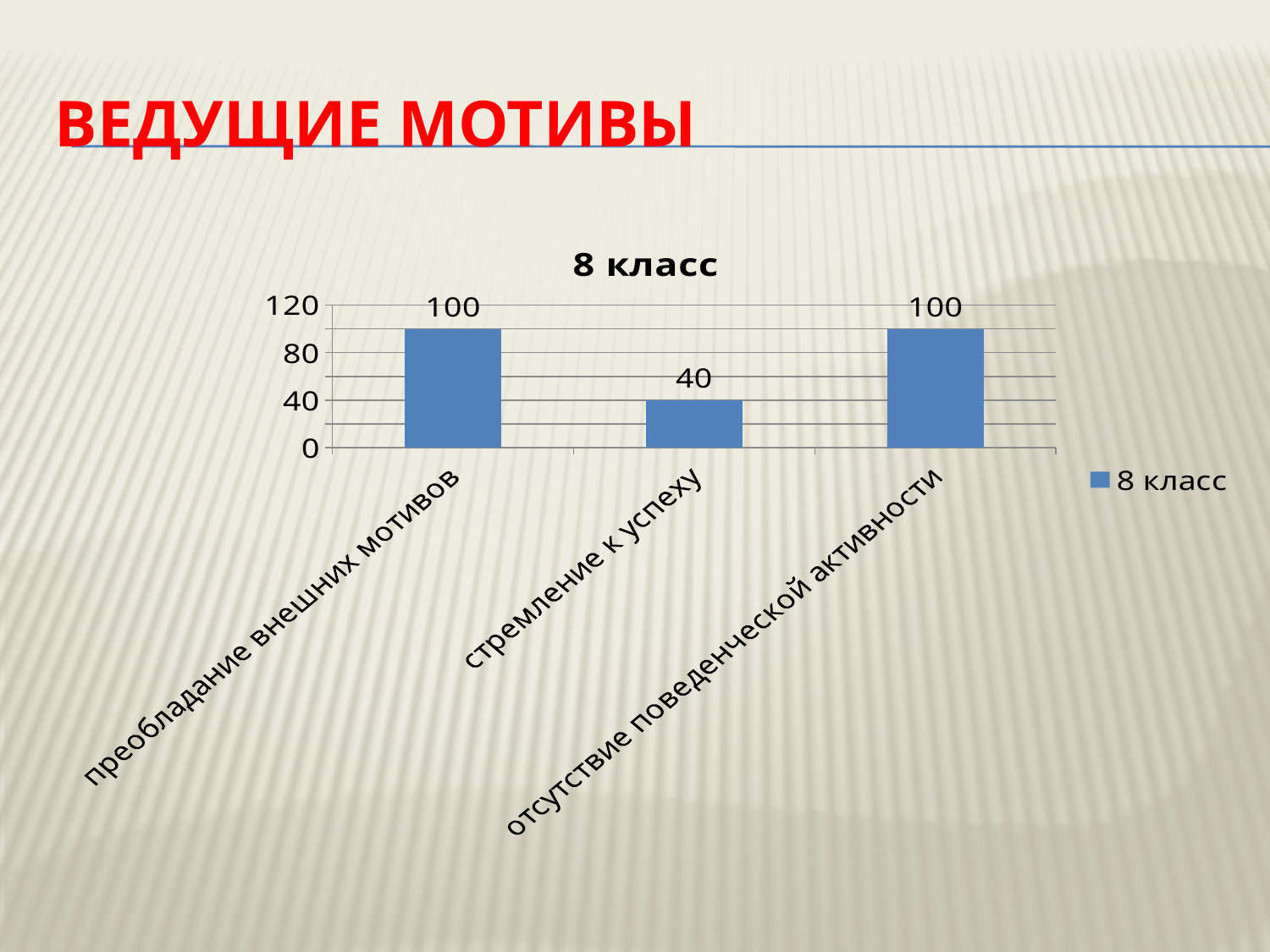
How many series does the legend list? 1 What is the value for "стремление к успеху"? 40 What is the value for "преобладание внешних мотивов"? 100 What is the difference between the values for "преобладание внешних мотивов" and "стремление к успеху"? 60 What is the title of the chart? 8 класс How many categories are shown on the x axis? 3 What kind of chart is shown? bar chart Which is larger: the value for "стремление к успеху" or the value for "отсутствие поведенческой активности"? отсутствие поведенческой активности Is the value for "стремление к успеху" greater or less than 80? less What is the highest value shown on the vertical axis? 120 What is the value for "отсутствие поведенческой активности"? 100 Which category has the lowest value? стремление к успеху